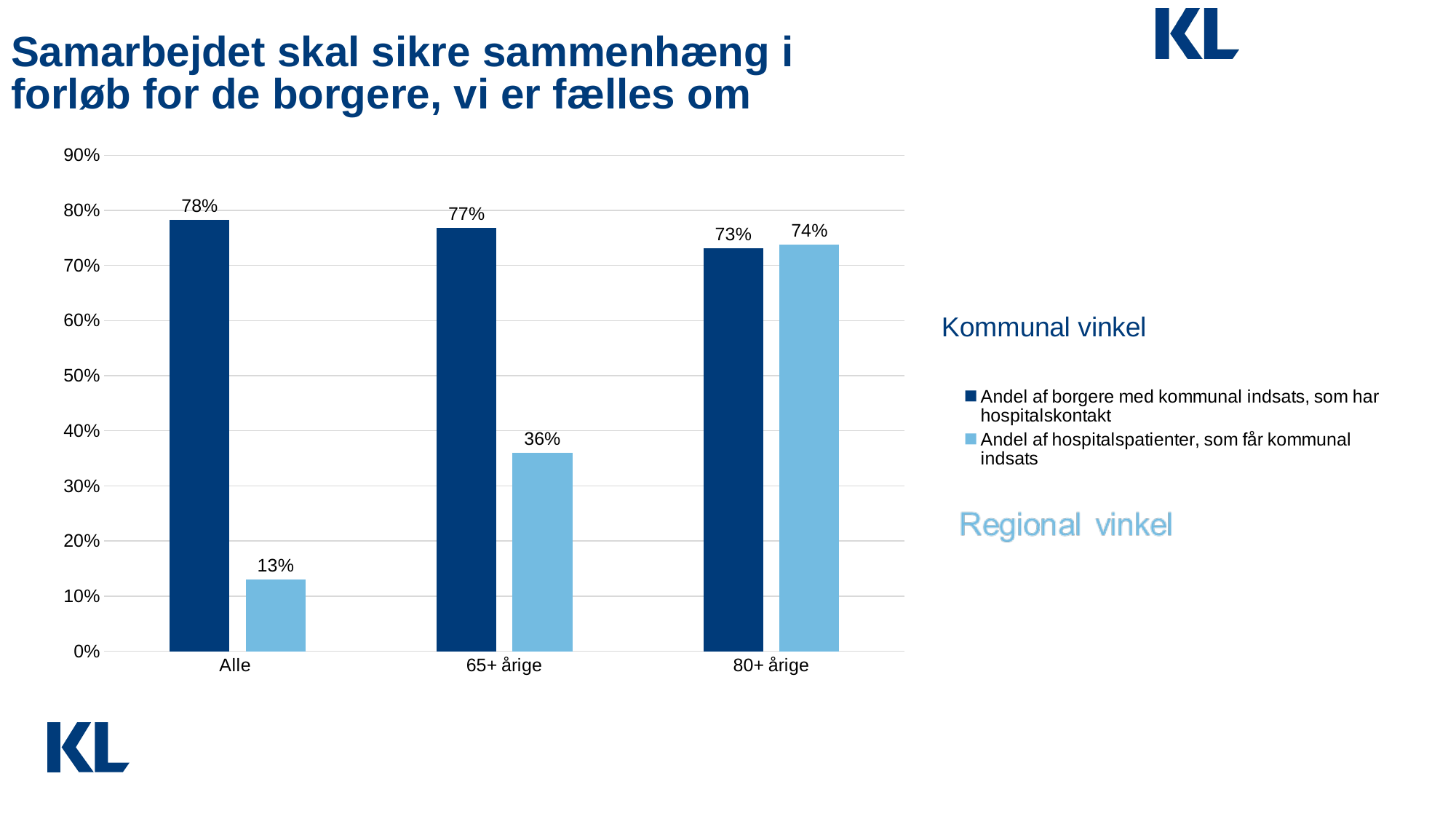
How many series does the legend list? 2 Does the value for 'Andel af hospitalspatienter, som får kommunal indsats' rise or fall from 'Alle' to '80+ årige'? Rise What is the difference between the two series in the 'Alle' category? 65 percentage points Which category has the lowest value for 'Andel af hospitalspatienter, som får kommunal indsats'? Alle What is the difference between the 'Andel af hospitalspatienter, som får kommunal indsats' values for '80+ årige' and '65+ årige'? 38 percentage points Which category has the highest value for 'Andel af borgere med kommunal indsats, som har hospitalskontakt'? Alle In the '65+ årige' category, which series has the larger value? Andel af borgere med kommunal indsats, som har hospitalskontakt What is the value for 'Andel af borgere med kommunal indsats, som har hospitalskontakt' in the 'Alle' category? 78% How many categories are shown on the x axis? 3 What kind of chart is shown on the slide? Bar chart What is the value for 'Andel af hospitalspatienter, som får kommunal indsats' in the '80+ årige' category? 74% What is the value for 'Andel af hospitalspatienter, som får kommunal indsats' in the '65+ årige' category? 36%